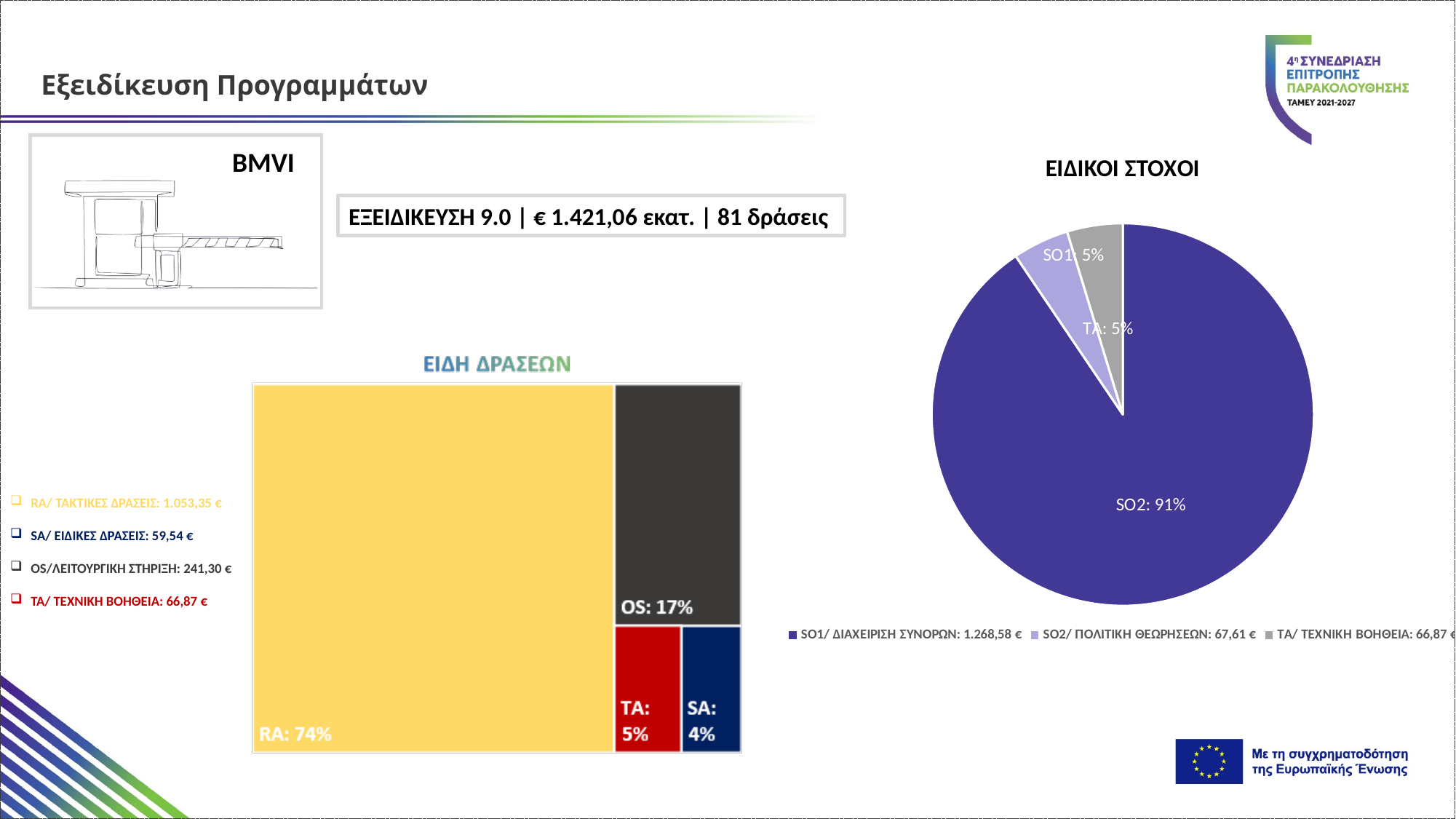
In the 'ΕΙΔΙΚΟΙ ΣΤΟΧΟΙ' pie chart, what percentage is printed on the largest slice? 91% In the 'ΕΙΔΗ ΔΡΑΣΕΩΝ' chart, which is larger, OS or TA? OS What kind of chart is the 'ΕΙΔΗ ΔΡΑΣΕΩΝ' chart? treemap In the 'ΕΙΔΗ ΔΡΑΣΕΩΝ' chart, what is the difference in percentage points between RA and OS? 57 What kind of chart is the 'ΕΙΔΙΚΟΙ ΣΤΟΧΟΙ' chart? pie chart In the 'ΕΙΔΗ ΔΡΑΣΕΩΝ' chart, what percentage is shown for RA? 74% In the legend of the 'ΕΙΔΙΚΟΙ ΣΤΟΧΟΙ' pie chart, what amount is given for SO1/ ΔΙΑΧΕΙΡΙΣΗ ΣΥΝΟΡΩΝ? 1.268,58 € In the 'ΕΙΔΗ ΔΡΑΣΕΩΝ' chart, what percentage is shown for OS? 17% In the 'ΕΙΔΗ ΔΡΑΣΕΩΝ' chart, which category has the largest share? RA In the 'ΕΙΔΗ ΔΡΑΣΕΩΝ' chart, which category has the smallest share? SA How many entries does the legend of the 'ΕΙΔΙΚΟΙ ΣΤΟΧΟΙ' pie chart list? 3 How many categories are shown in the 'ΕΙΔΗ ΔΡΑΣΕΩΝ' chart? 4